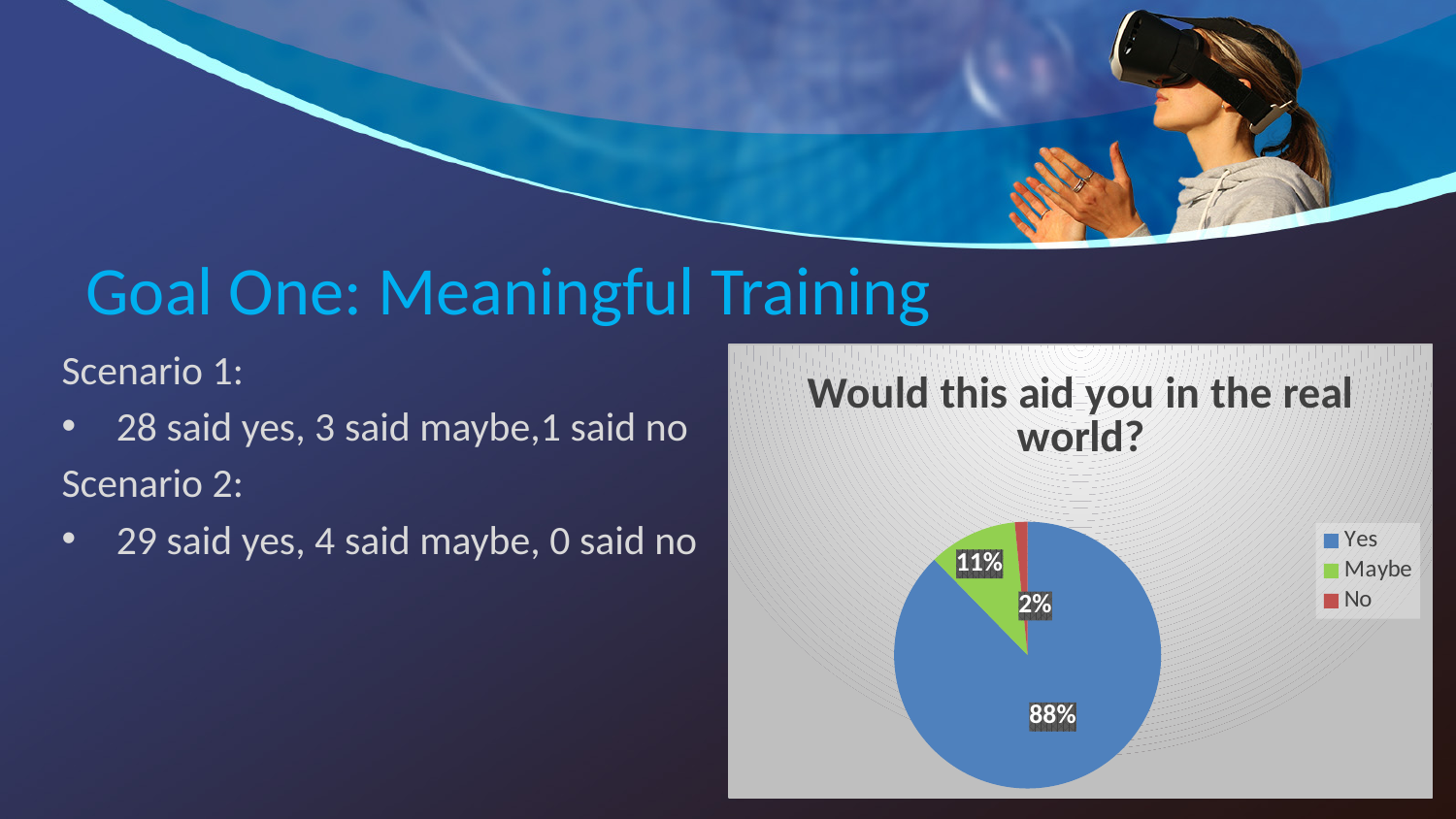
What is the title of the chart? Would this aid you in the real world? Which category has the largest slice of the pie? Yes What percentage of the pie is labelled for No? 2% Which category has the smallest slice of the pie? No What colour is the Maybe slice in the pie chart? green How many categories does the legend list? 3 What kind of chart is shown on the slide? pie chart What is the difference in percentage points between the Maybe slice and the No slice? 9 What percentage of the pie is labelled for Yes? 88% Which is larger, the Maybe slice or the No slice? Maybe What percentage of the pie is labelled for Maybe? 11% What is the difference in percentage points between the Yes slice and the Maybe slice? 77